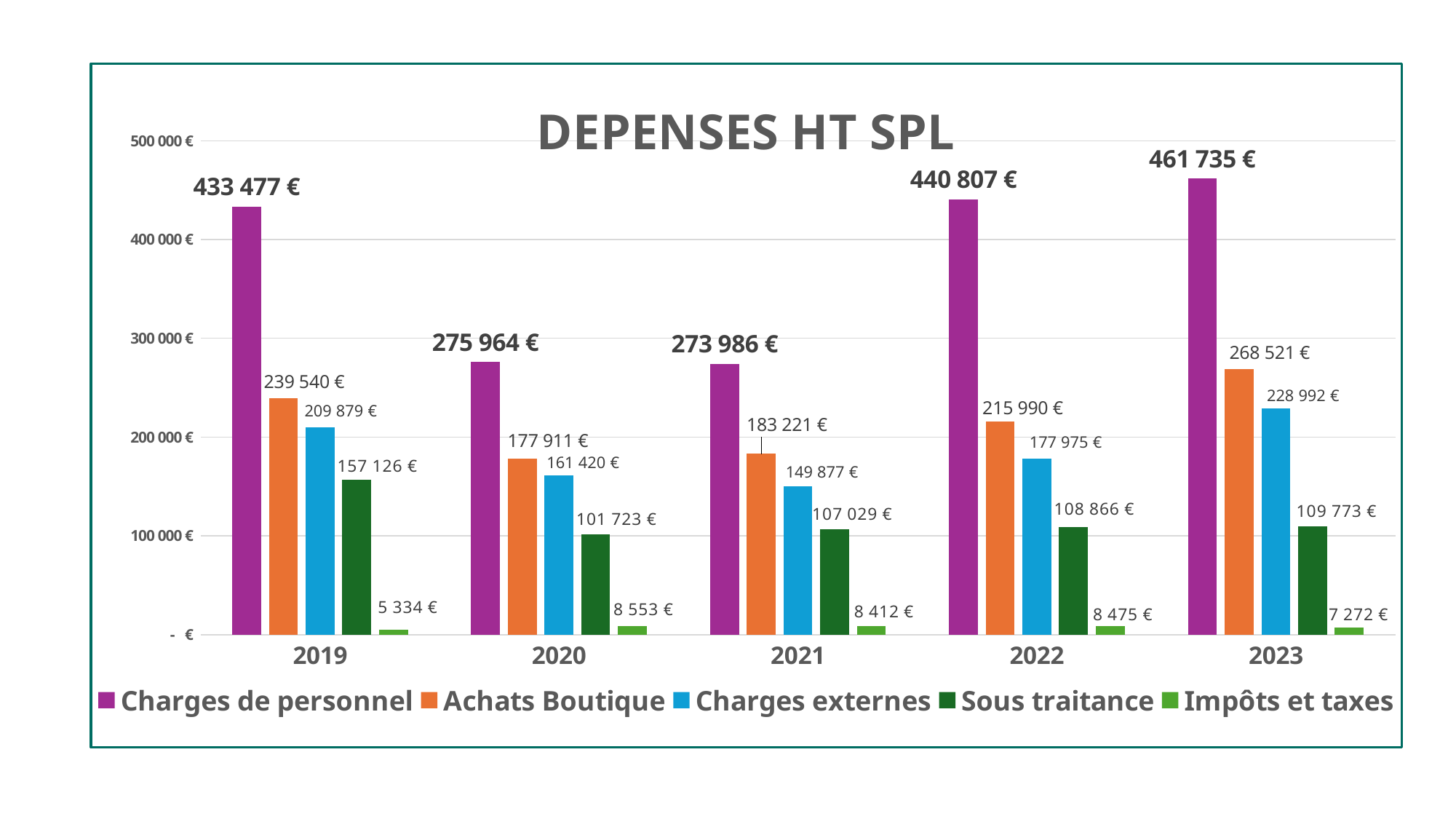
What is the value for Sous traitance in 2021? 107 029 € What kind of chart is shown? Bar chart What is the value for Achats Boutique in 2019? 239 540 € In which year is Charges de personnel highest? 2023 What is the value for Charges de personnel in 2023? 461 735 € Which is larger: Achats Boutique in 2022 or Charges externes in 2023? Charges externes in 2023 What is the value for Impôts et taxes in 2020? 8 553 € How many years are shown on the x axis? 5 In which year is Charges externes lowest? 2021 What is the difference between Charges de personnel in 2022 and in 2021? 166 821 € How many series does the legend list? 5 Is the value for Charges de personnel in 2020 greater or less than 300 000 €? less